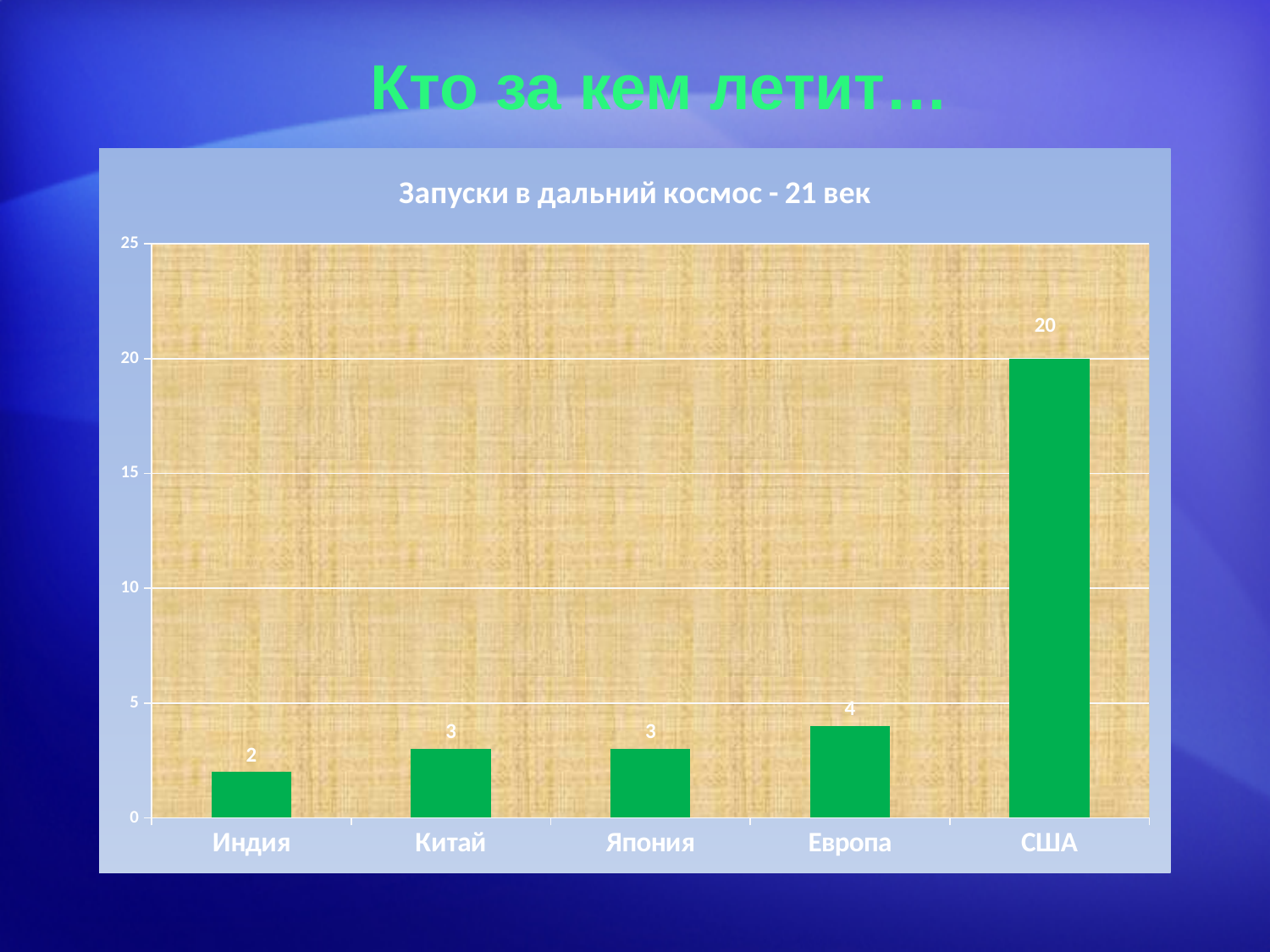
What is the difference between the values for США and Европа? 16 What is the value for Европа in the chart? 4 Which is larger, the value for Европа or the value for Япония? Европа What is the value for США in the chart? 20 Which category has the lowest value? Индия What is the difference between the values for Китай and Индия? 1 Which category has the highest value? США What is the value for Индия in the chart? 2 Is the value for США greater or less than 15? greater What kind of chart is shown on the slide? bar chart What is the title of the chart? Запуски в дальний космос - 21 век How many categories are shown on the x axis? 5